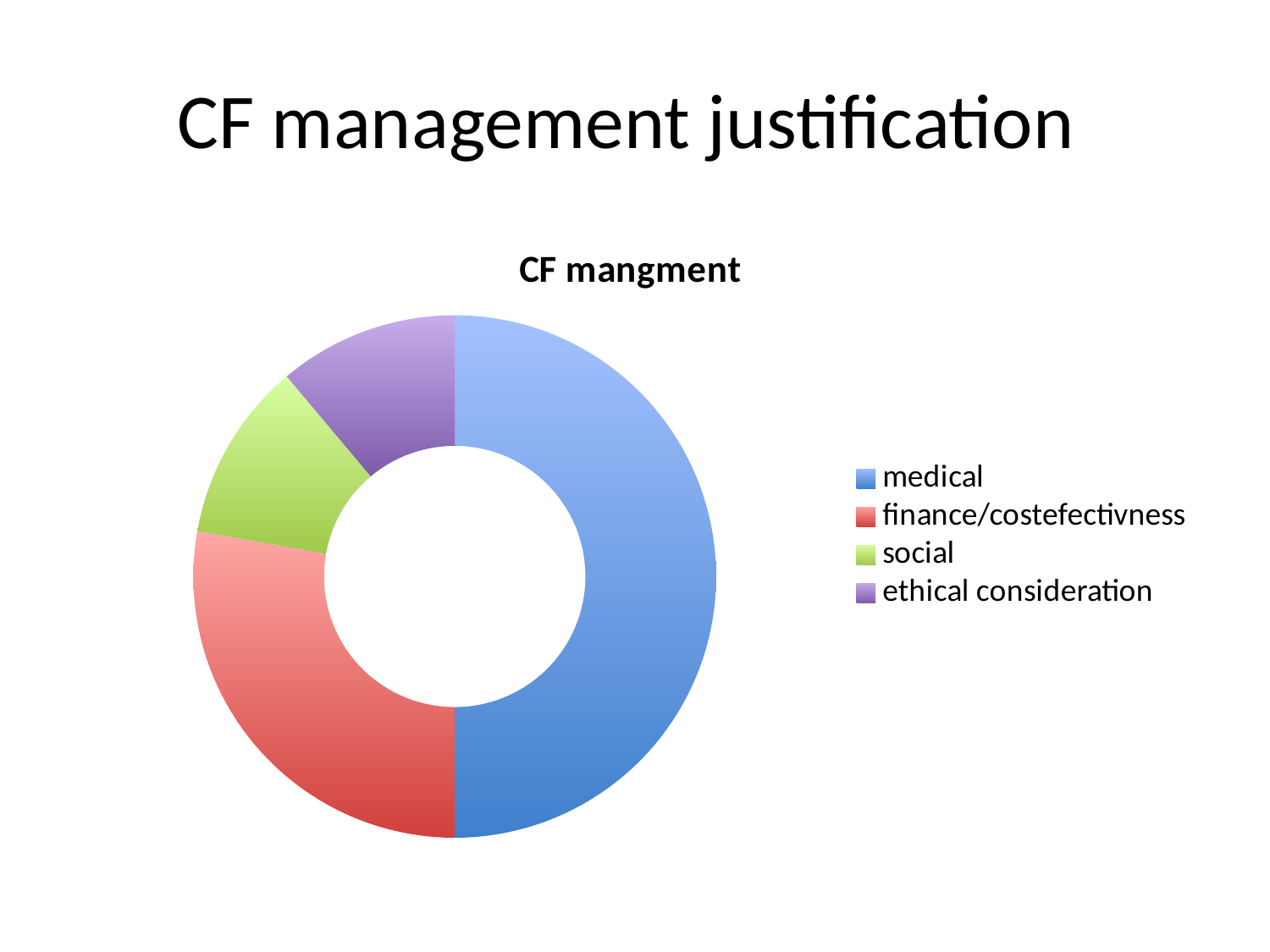
Which colour represents the social category in the chart? Green Which is larger, the share for medical or the share for ethical consideration? medical Which is larger, the share for finance/costefectivness or the share for social? finance/costefectivness What kind of chart is shown on the slide? Doughnut chart What is the title of the chart? CF mangment Which category has the largest share of the chart? medical Which is larger, the share for medical or the share for finance/costefectivness? medical How many categories does the chart show? 4